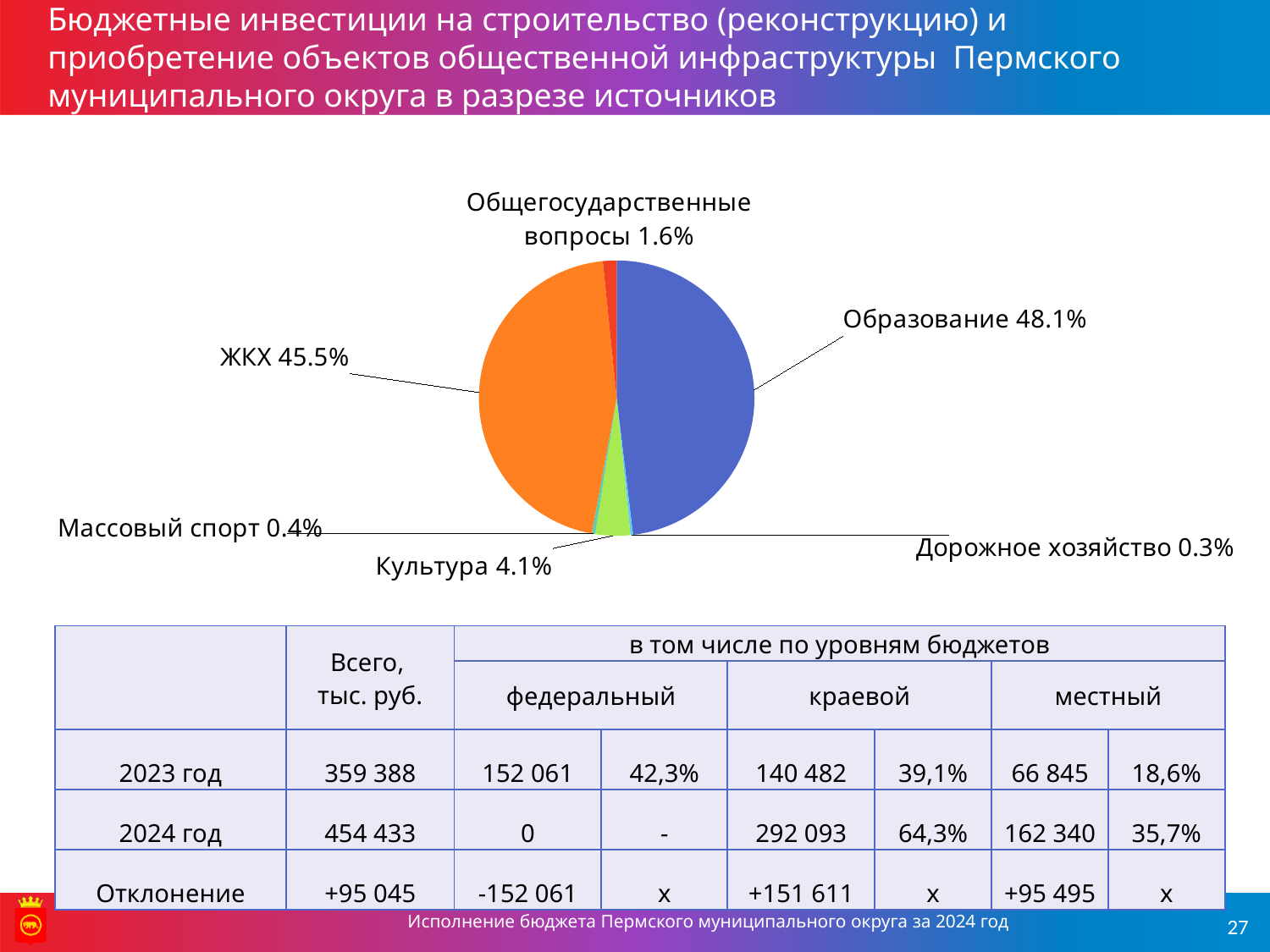
How many slices does the pie chart have? 6 Which category has the smallest slice of the pie? Дорожное хозяйство Which category has the largest slice of the pie? Образование What share of the pie does ЖКХ have? 45.5% What kind of chart is shown on the slide? pie chart What share of the pie does Культура have? 4.1% What share of the pie does Общегосударственные вопросы have? 1.6% What share of the pie does Образование have? 48.1% What colour is the slice for ЖКХ? orange What share of the pie does Дорожное хозяйство have? 0.3% Which is larger, the share for Культура or the share for Общегосударственные вопросы? Культура What is the difference in percentage points between Образование and ЖКХ? 2.6